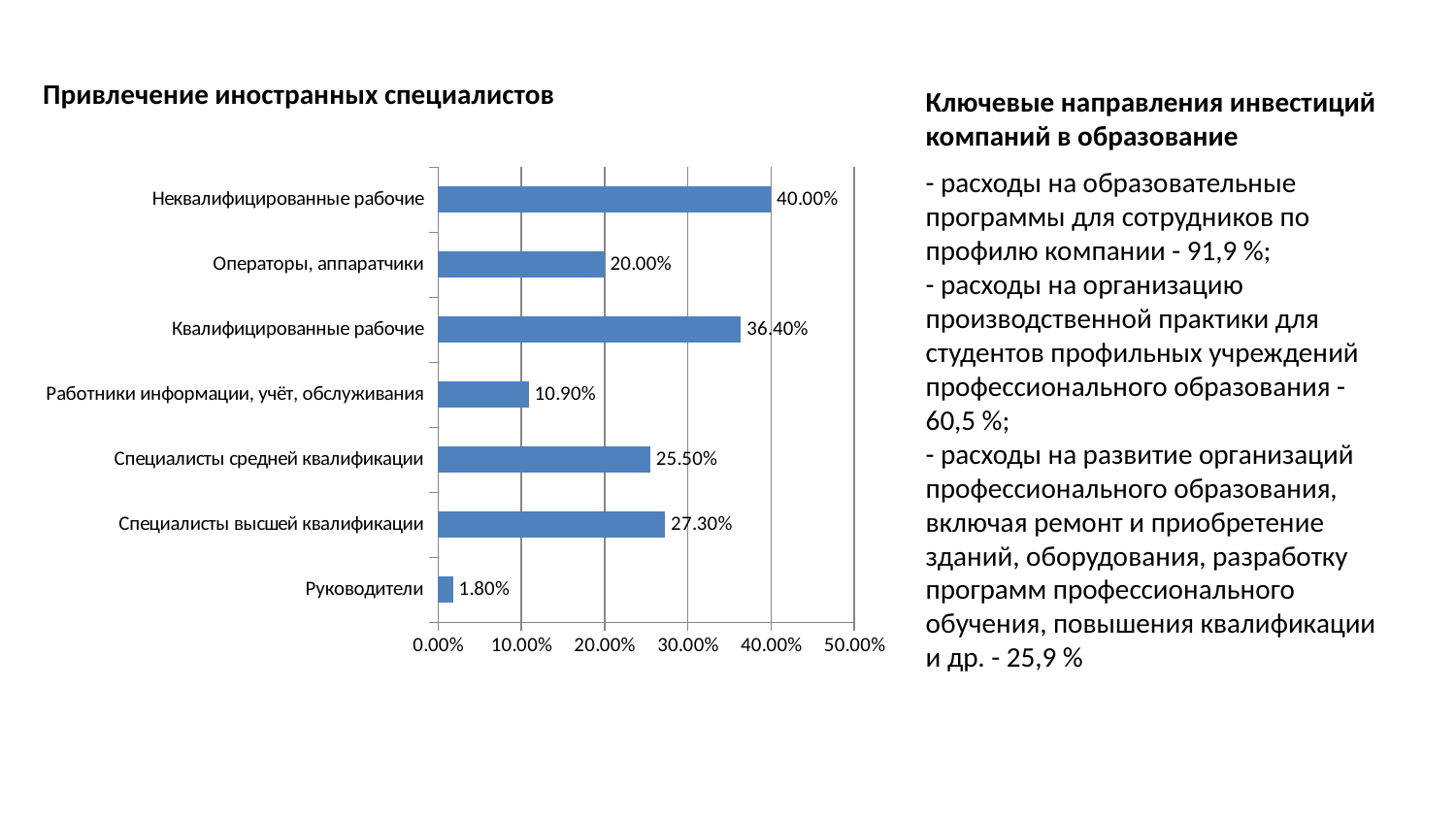
What is the value for Руководители? 1.80% What is the difference between the values for Специалисты высшей квалификации and Специалисты средней квалификации? 1.80% What is the title of the chart? Привлечение иностранных специалистов What is the difference between the values for Неквалифицированные рабочие and Квалифицированные рабочие? 3.60% Which category has the lowest value? Руководители Which category has the highest value? Неквалифицированные рабочие How many categories are shown in the chart? 7 What is the value for Неквалифицированные рабочие? 40.00% Which is larger, the value for Специалисты высшей квалификации or Специалисты средней квалификации? Специалисты высшей квалификации Is the value for Операторы, аппаратчики greater or less than 30.00%? less What kind of chart is shown on the slide? bar chart What is the value for Работники информации, учёт, обслуживания? 10.90%